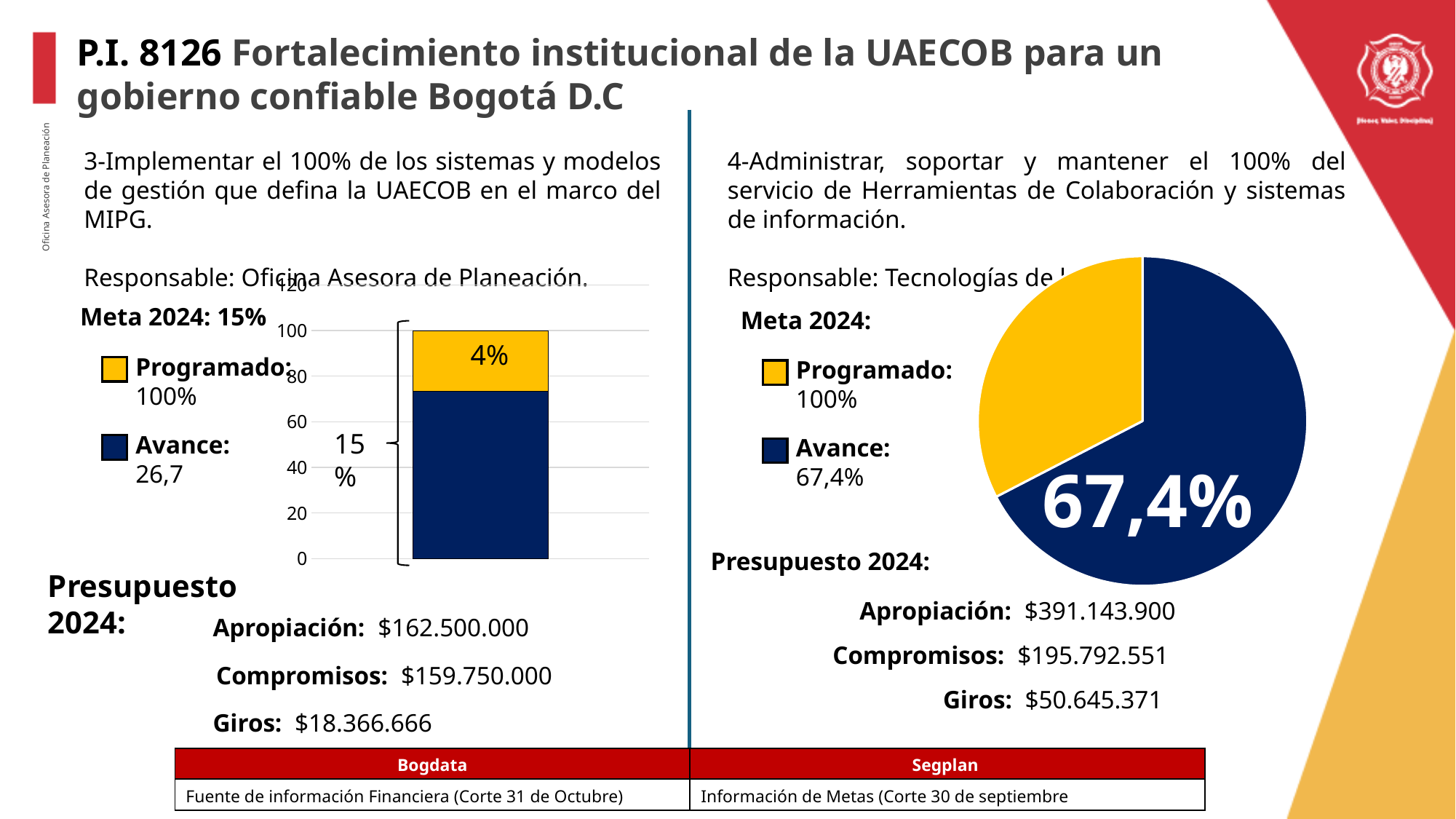
In the left bar chart, what value is printed on the yellow segment of the bar? 4% In the left bar chart, how many bars are plotted? 1 What kind of chart is shown on the left side of the slide? bar chart In the right pie chart, which slice is larger, the navy one or the yellow one? navy What kind of chart is shown on the right side of the slide? pie chart In the left bar chart, is the top of the navy segment greater or less than 80? less In the right pie chart, what percentage is printed on the navy slice? 67,4% In the left bar chart, what axis value does the top of the stacked bar reach? 100 In the left bar chart, what is the highest tick value shown on the vertical axis? 120 In the left bar chart, is the top of the navy segment greater or less than 60? greater In the right pie chart, how many slices are there? 2 In the left bar chart, what percentage is written next to the bracket beside the bar? 15%